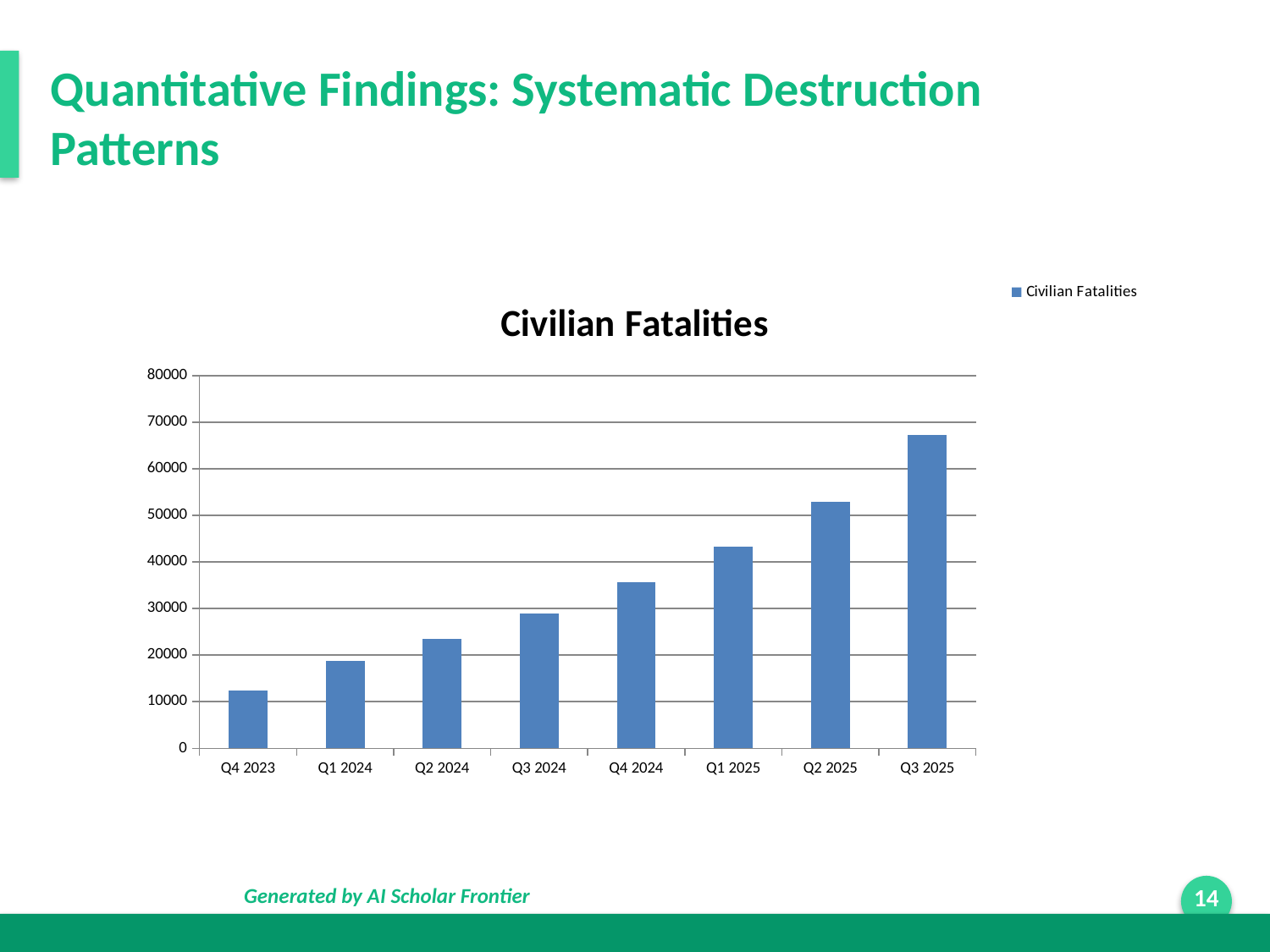
How many quarters are shown on the x axis of the chart? 8 Which is larger, the value for Q2 2025 or the value for Q2 2024? Q2 2025 What kind of chart is shown on the slide? bar chart What is the title of the chart? Civilian Fatalities Is the value for Q4 2023 greater or less than 20000? less Do civilian fatalities rise or fall from Q4 2023 to Q3 2025? rise Is the value for Q4 2024 greater or less than 40000? less Is the value for Q1 2025 greater or less than 40000? greater Which quarter has the lowest civilian fatalities? Q4 2023 How many series does the legend list? 1 Which quarter has the highest civilian fatalities? Q3 2025